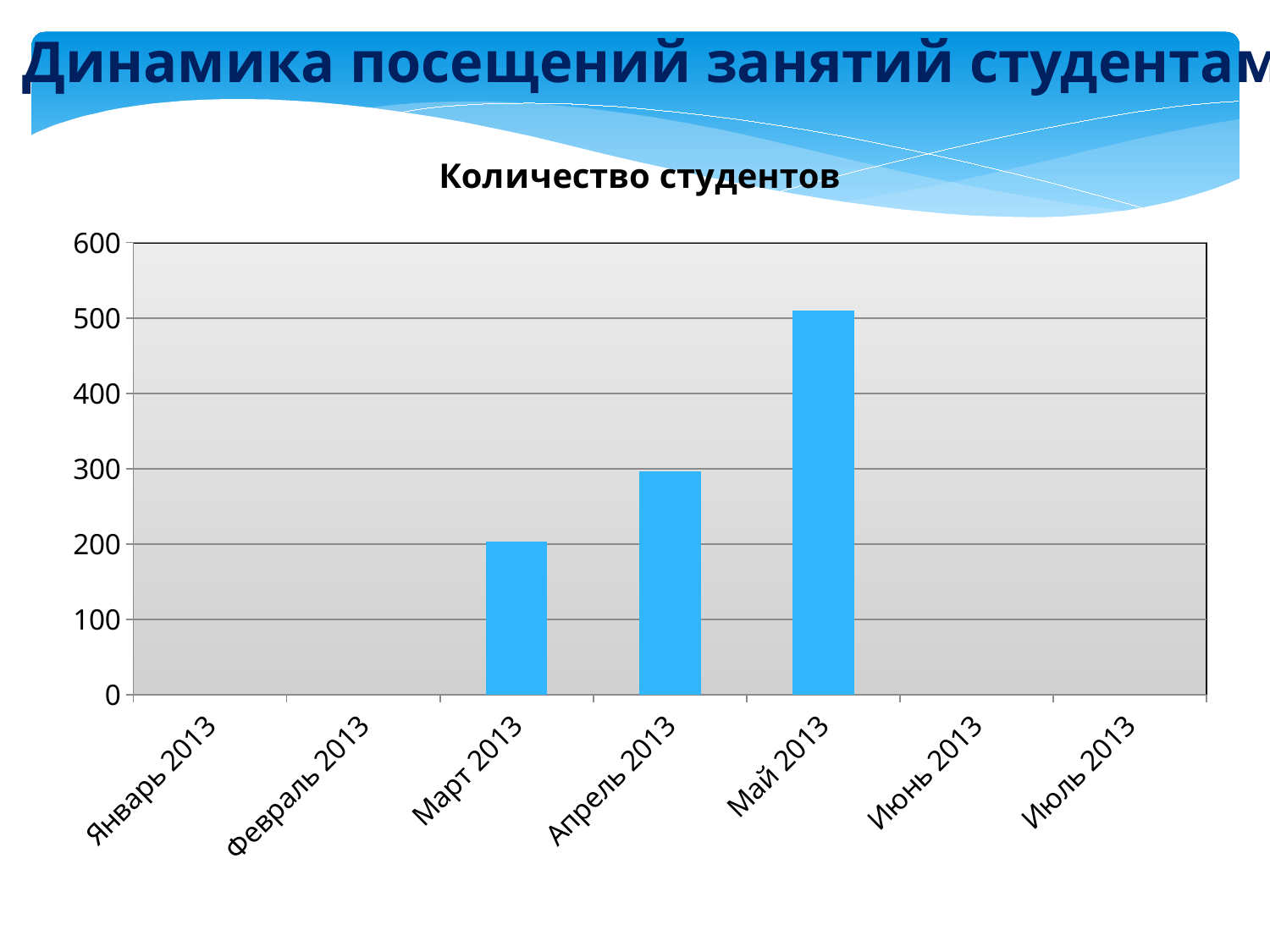
How many months have a visible bar in the chart? 3 Do the values rise or fall from Март 2013 to Май 2013? rise Is the value for Март 2013 greater or less than 300? less Which month has the highest value in the chart? Май 2013 Which is larger, the value for Апрель 2013 or the value for Май 2013? Май 2013 Is the value for Апрель 2013 greater or less than 200? greater Which is larger, the value for Март 2013 or the value for Апрель 2013? Апрель 2013 Is the value for Май 2013 greater or less than 400? greater What kind of chart is shown on the slide? bar chart What is the title of the chart? Количество студентов Among the months with a visible bar, which has the lowest value? Март 2013 How many categories are shown on the x axis of the chart? 7